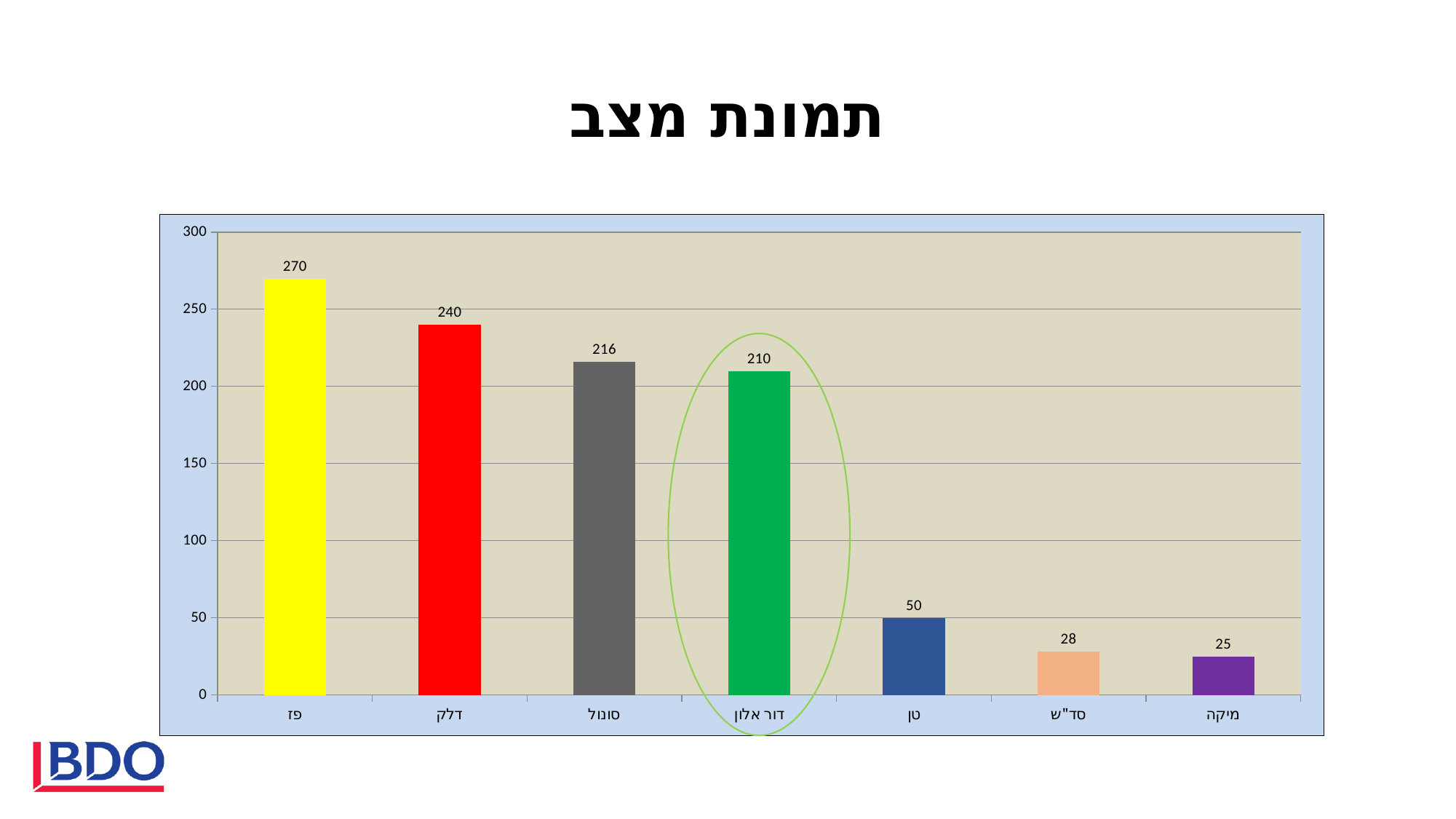
Which bar is circled on the chart? דור אלון What is the value for סד"ש? 28 Which is larger, the value for סונול or the value for דור אלון? סונול What is the difference between the values for פז and דלק? 30 How many categories are shown on the chart? 7 Is the value for דלק greater or less than 200? greater Which category has the lowest value? מיקה What is the value for פז? 270 What is the difference between the values for טן and מיקה? 25 Which category has the highest value? פז What kind of chart is shown on the slide? bar chart What is the value for דור אלון? 210